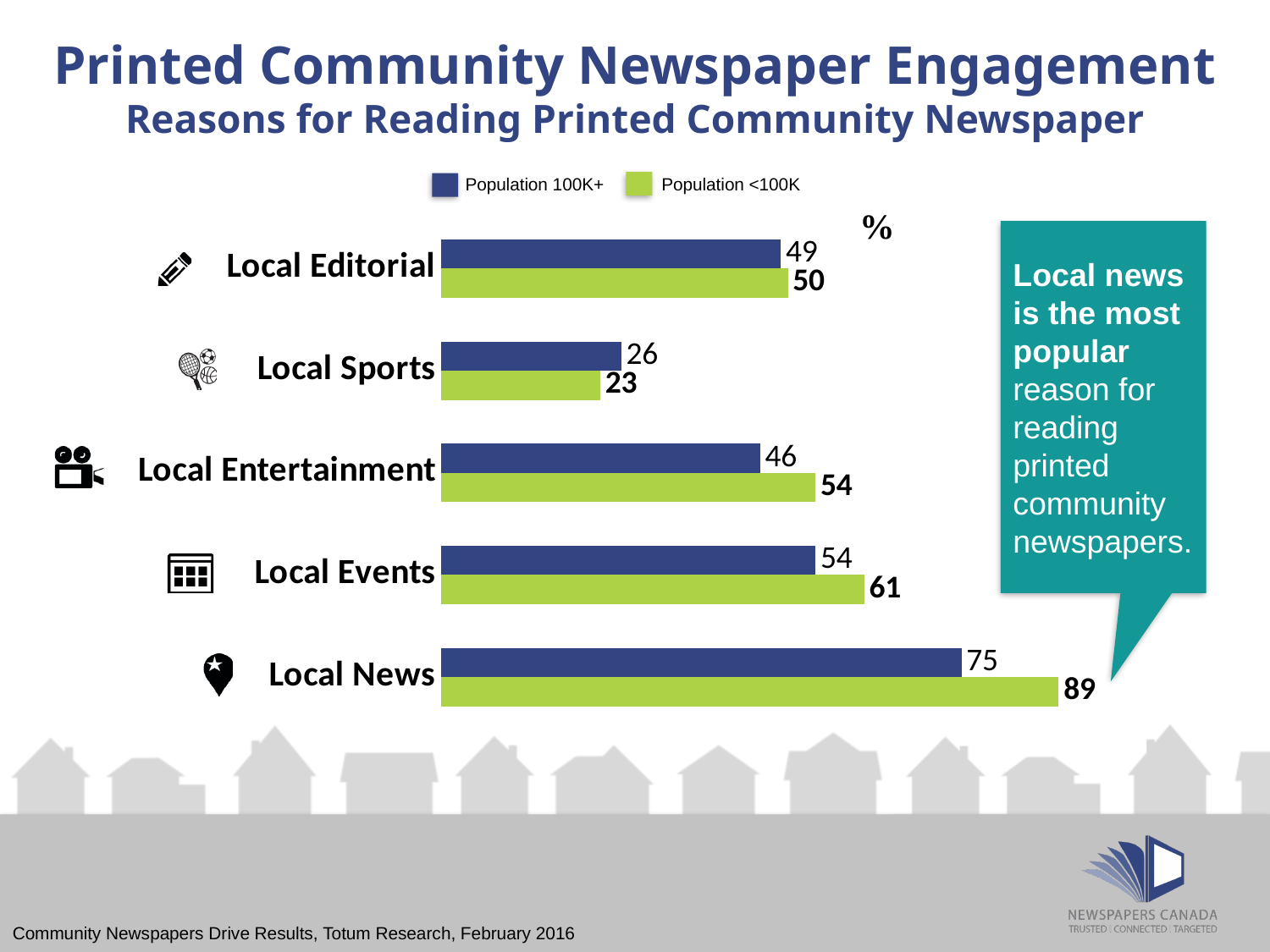
What is the difference between the Population <100K and Population 100K+ values for Local News? 14 How many series does the legend list? 2 Which category has the lowest value in the Population <100K series? Local Sports What is the value for Local Sports in the Population 100K+ series? 26 How many categories are shown in the chart? 5 What is the value for Local Entertainment in the Population <100K series? 54 What is the difference between the Population <100K and Population 100K+ values for Local Events? 7 What is the value for Local News in the Population <100K series? 89 What kind of chart is shown on the slide? Bar chart Which category has the highest value in the Population 100K+ series? Local News Which colour represents the Population <100K series? Green For Local Sports, which series has the larger value, Population 100K+ or Population <100K? Population 100K+